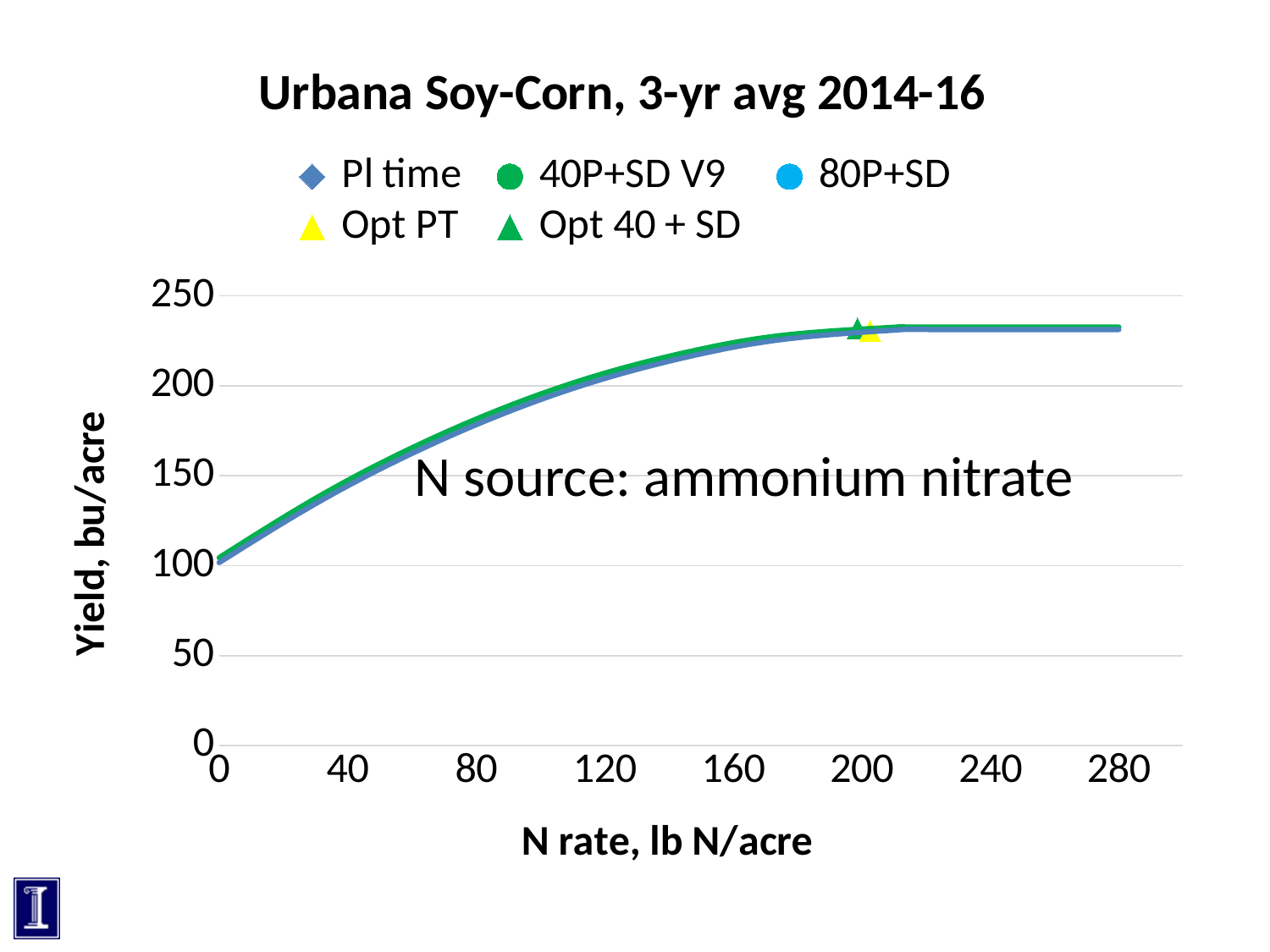
Is the yield for Pl time at an N rate of 80 greater or less than 200? less What kind of chart is shown on the slide? line chart Is the yield for 40P+SD V9 at an N rate of 40 greater or less than 100? greater Do the yield curves rise or fall as N rate increases from 0 to 200 lb N/acre? rise Is the yield for 80P+SD at an N rate of 160 greater or less than 200? greater What is the label of the y axis? Yield, bu/acre How many series does the legend list? 5 What is the title of the chart? Urbana Soy-Corn, 3-yr avg 2014-16